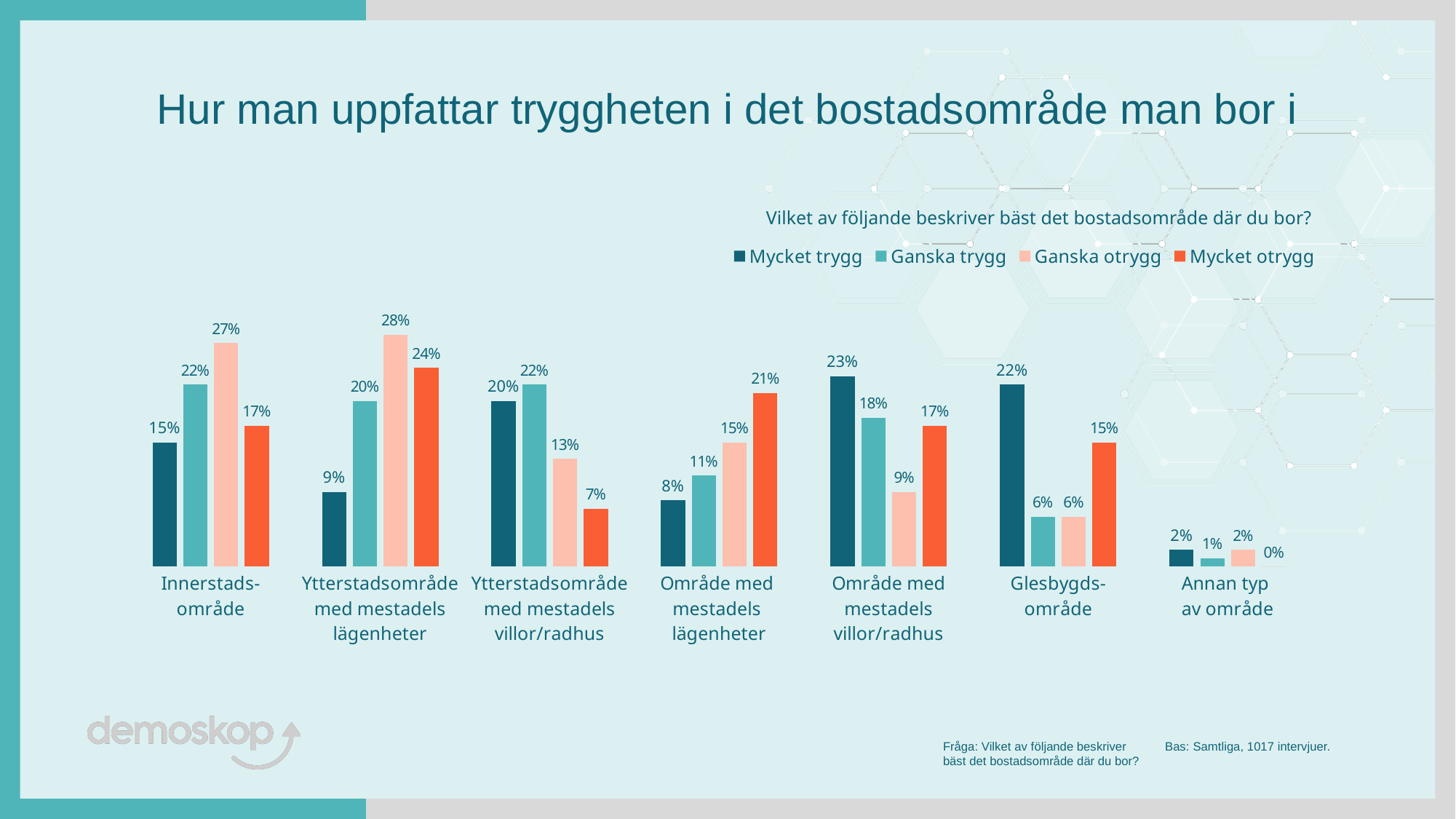
Which category has the highest value for Mycket trygg? Område med mestadels villor/radhus What is the value for Mycket otrygg in Område med mestadels lägenheter? 21% How many series does the legend list? 4 What is the value for Ganska trygg in Glesbygdsområde? 6% What is the title of the slide? Hur man uppfattar tryggheten i det bostadsområde man bor i What is the value for Mycket trygg in Innerstadsområde? 15% How many categories are shown on the x axis? 7 Which category has the lowest value for Mycket otrygg? Annan typ av område Which is larger in Område med mestadels villor/radhus: Mycket trygg or Ganska trygg? Mycket trygg What is the value for Ganska otrygg in Ytterstadsområde med mestadels lägenheter? 28% What is the difference between Ganska otrygg and Mycket trygg in Innerstadsområde? 12% What kind of chart is shown on the slide? Bar chart